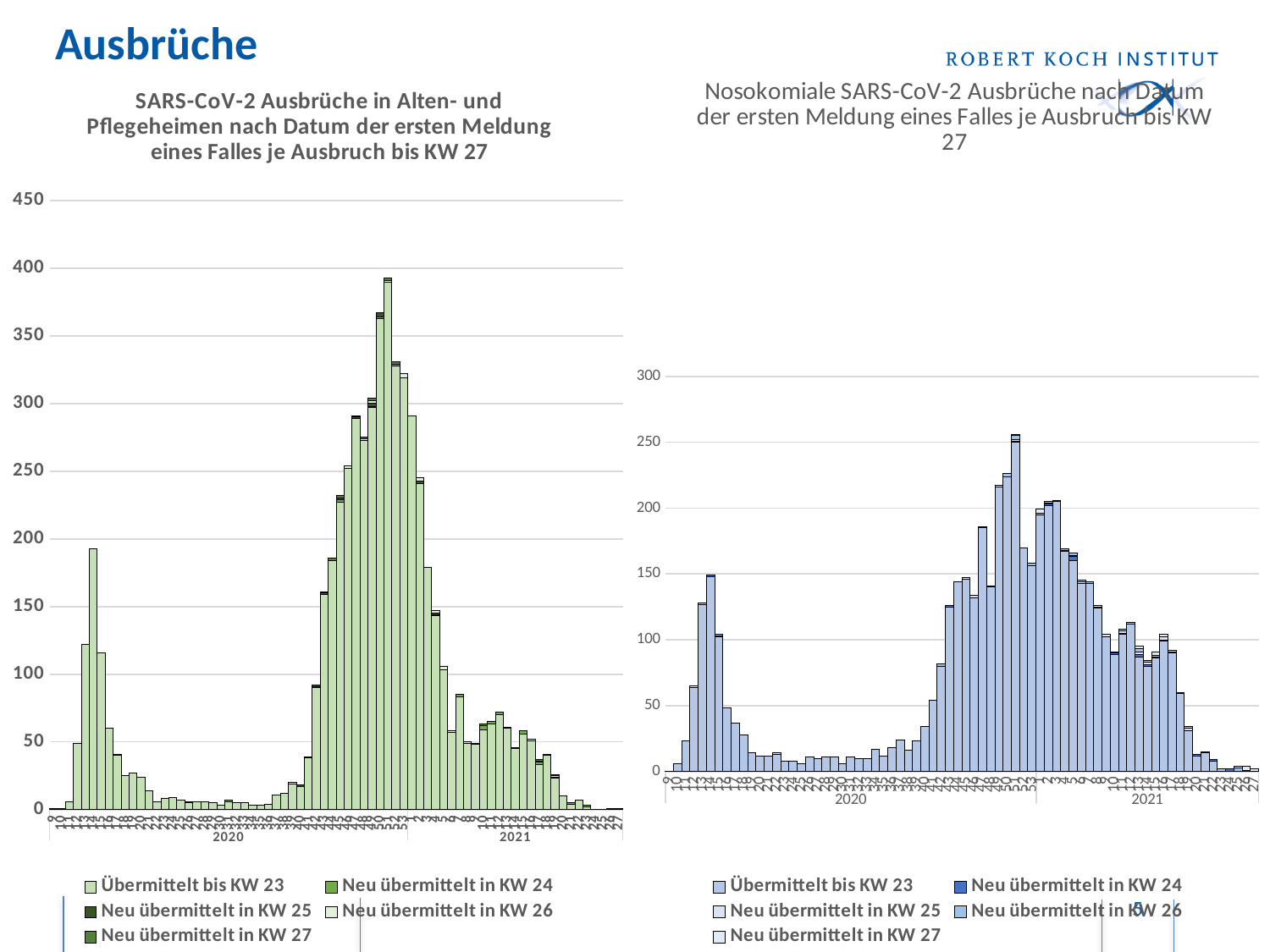
What kind of chart is the left chart, 'SARS-CoV-2 Ausbrüche in Alten- und Pflegeheimen'? Bar chart How many series does the legend of the right chart list? 5 In the left chart, is the value of the tallest bar greater or less than 400? less What is the first legend entry of the right chart? Übermittelt bis KW 23 How many series does the legend of the left chart list? 5 In the right chart, is the value of the tallest bar greater or less than 300? less Which two years are labelled on the x-axis of the left chart? 2020 and 2021 In the left chart, is the value of the tallest bar greater or less than 350? greater What kind of chart is the right chart, 'Nosokomiale SARS-CoV-2 Ausbrüche'? Bar chart What is the highest value shown on the y-axis of the left chart? 450